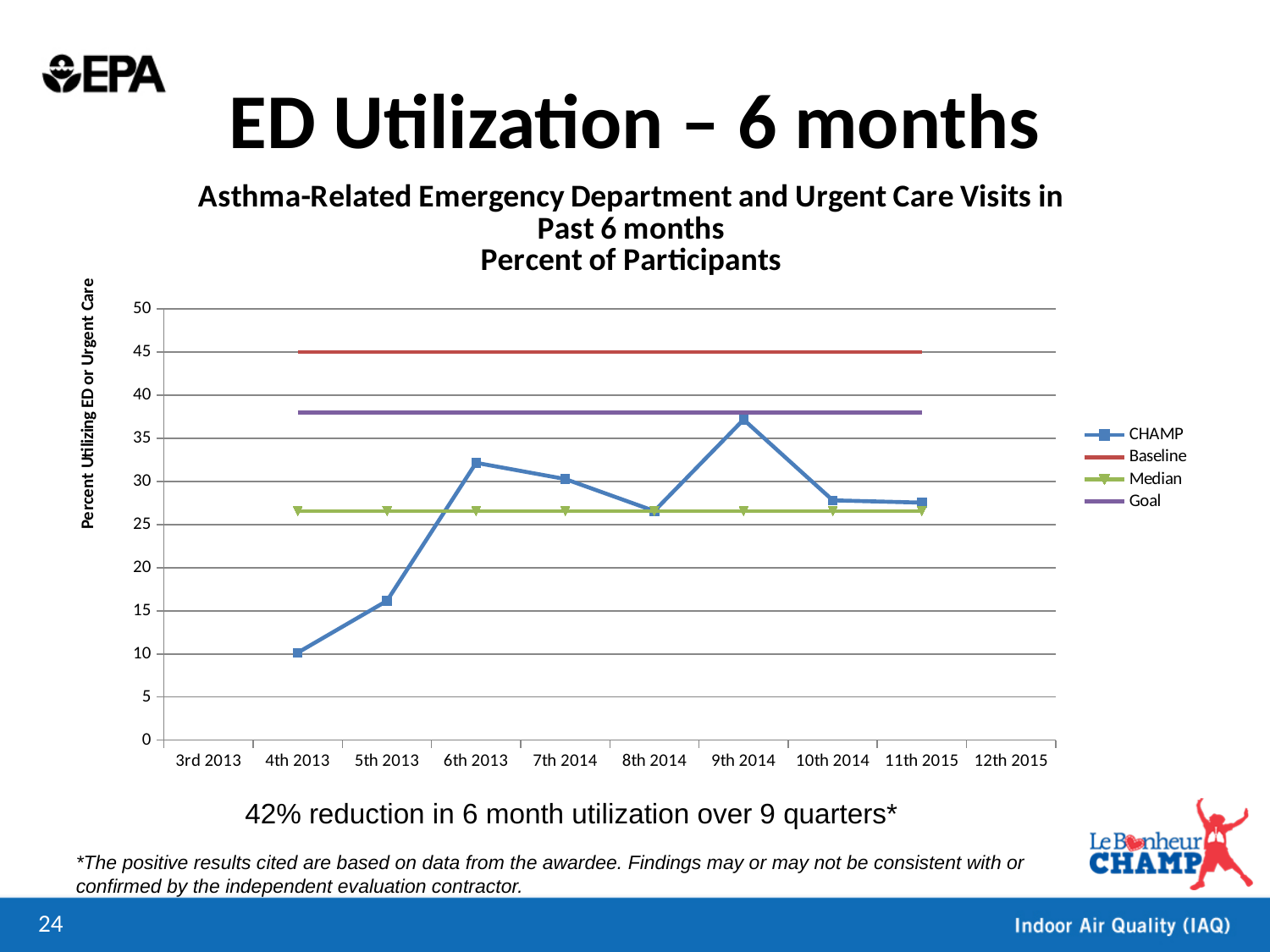
Does the CHAMP series rise or fall from 4th 2013 to 6th 2013? rise At which quarter does the CHAMP series have its lowest value? 4th 2013 What value does the Baseline line sit at? 45 Is the CHAMP value for 6th 2013 greater or less than 30? greater At which quarter does the CHAMP series reach its highest value? 9th 2014 Is the CHAMP value for 9th 2014 greater or less than 35? greater What is the title of the y axis? Percent Utilizing ED or Urgent Care How many series does the legend list? 4 What kind of chart is shown on the slide? line chart Which is larger, the CHAMP value for 5th 2013 or for 6th 2013? 6th 2013 How many categories are shown along the x axis? 10 Is the CHAMP value for 4th 2013 greater or less than 15? less